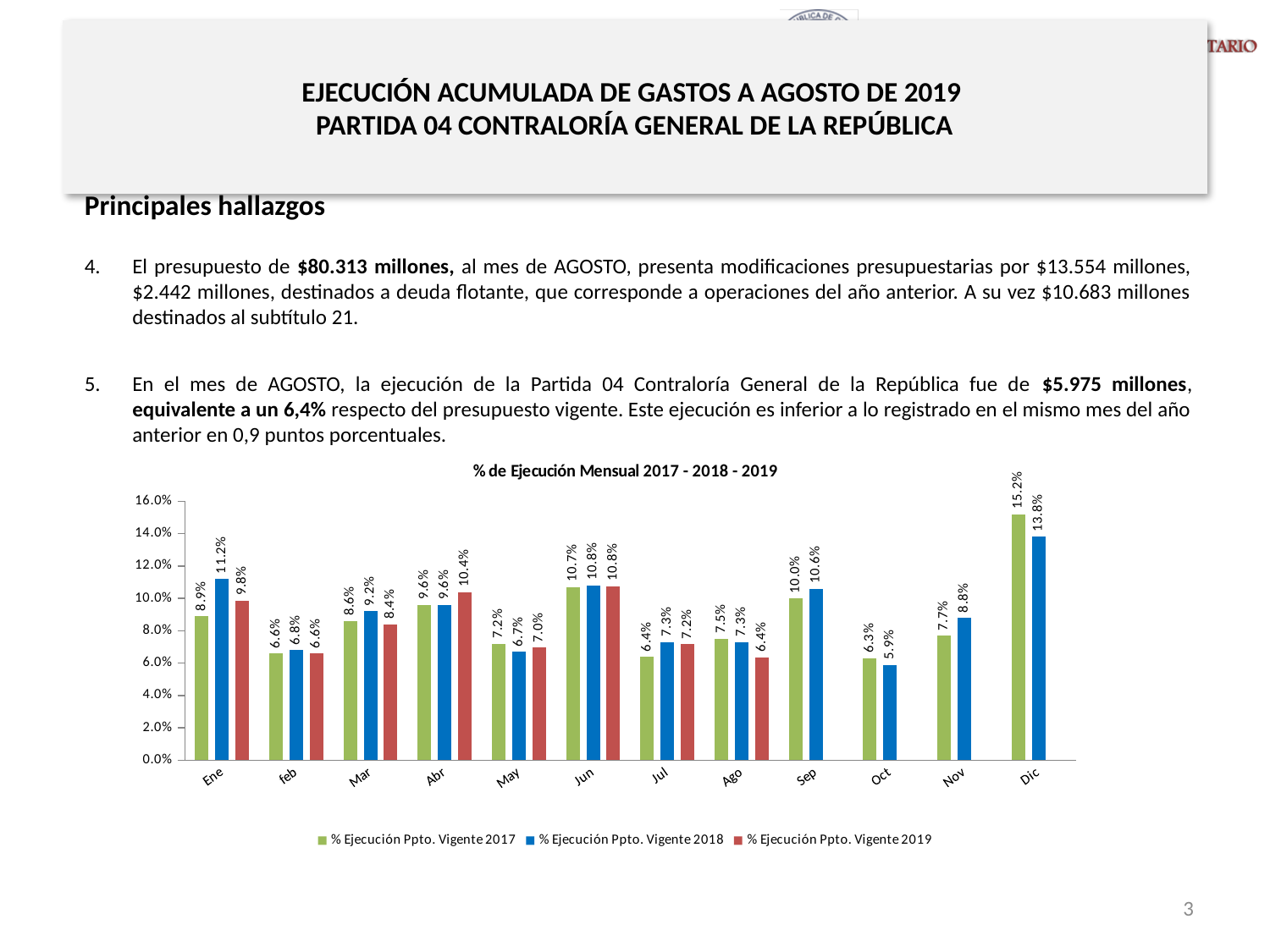
What is the difference between the 2018 and 2017 values in Ene? 2.3 percentage points What kind of chart is shown on the slide? Bar chart How many series does the legend list? 3 In which month is the % Ejecución Ppto. Vigente 2018 series highest? Dic What is the title of the chart? % de Ejecución Mensual 2017 - 2018 - 2019 Which is larger in Abr: the 2019 value or the 2017 value? 2019 value What is the value for % Ejecución Ppto. Vigente 2019 in Ago? 6.4% In which month is the % Ejecución Ppto. Vigente 2018 series lowest? Oct How many months are shown on the x axis? 12 Is the value for % Ejecución Ppto. Vigente 2017 in Dic greater or less than 14.0%? greater What is the value for % Ejecución Ppto. Vigente 2018 in Ene? 11.2% What is the value for % Ejecución Ppto. Vigente 2017 in Dic? 15.2%